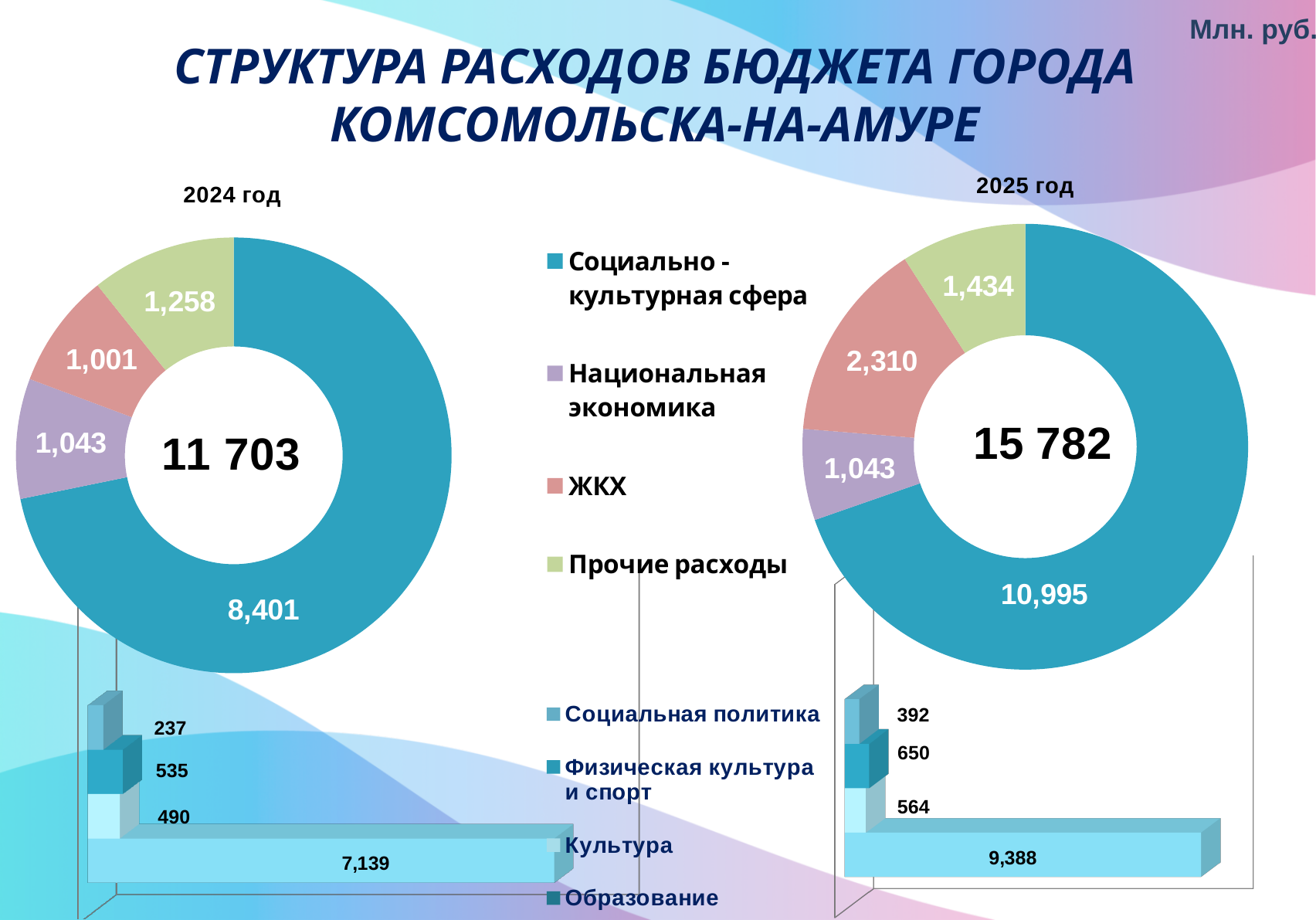
How many categories does the legend of the donut charts list? 4 What is the difference between the ЖКХ values in the 2025 and 2024 donut charts? 1,309 In the 2025 donut chart, what is the value for ЖКХ? 2,310 In the 2025 bar chart at the bottom right, what is the value for Физическая культура и спорт? 650 What total is shown in the centre of the 2025 donut chart? 15 782 What type of chart is shown at the bottom of the slide for Социальная политика, Физическая культура и спорт, Культура and Образование? Bar chart In the 2025 donut chart, which category has the largest value? Социально-культурная сфера In the 2024 donut chart, which is larger: Национальная экономика or Прочие расходы? Прочие расходы In the 2024 bar chart at the bottom left, what is the value for Образование? 7,139 In the 2025 bar chart at the bottom right, which category has the lowest value? Социальная политика In the 2024 donut chart, what is the value for Социально-культурная сфера? 8,401 In the 2024 donut chart, which category has the smallest value? ЖКХ